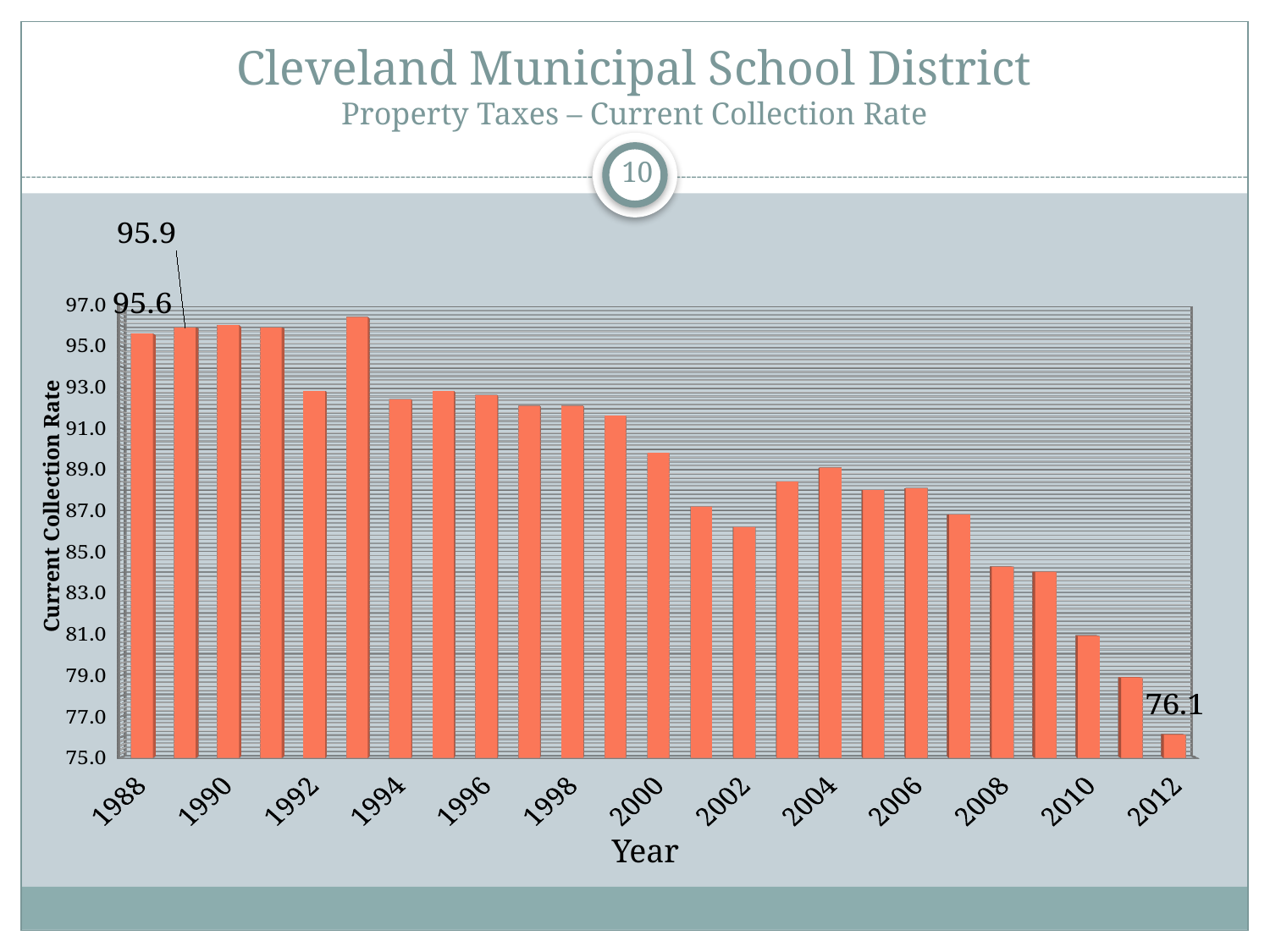
Do the collection rates generally rise or fall from 1988 to 2012? fall Which year has the lowest current collection rate? 2012 Is the value for 2010 greater or less than 83.0? less What is the current collection rate for 1988? 95.6 What is the difference between the collection rates for 1989 and 2012? 19.8 What is the current collection rate for 1989? 95.9 How many years are plotted on the chart? 25 What kind of chart is shown on the slide? bar chart What is the current collection rate for 2012? 76.1 Is the value for 2002 greater or less than 87.0? less Which is larger, the collection rate for 1988 or for 2012? 1988 What is the difference between the collection rates for 1989 and 1988? 0.3